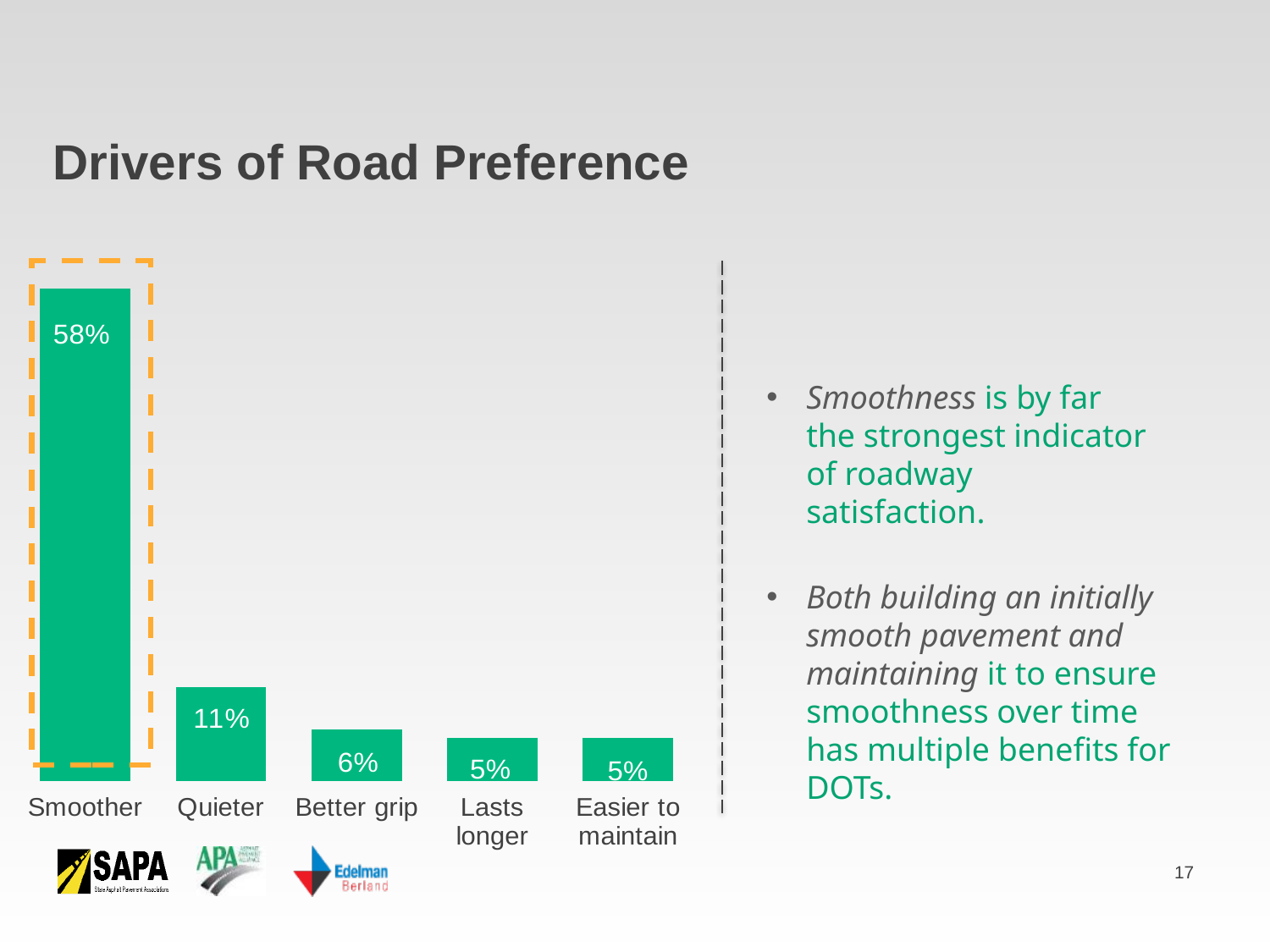
What percentage is shown for Lasts longer? 5% What is the difference between the values for Quieter and Better grip? 5% Which category has the highest value? Smoother Which is larger, the value for Quieter or the value for Better grip? Quieter What percentage is shown for Smoother? 58% What is the difference between the values for Smoother and Quieter? 47% Do the values rise or fall from left to right across the categories? Fall What kind of chart is shown on the slide? Bar chart What percentage is shown for Quieter? 11% What percentage is shown for Better grip? 6% Which bar is highlighted with a dashed orange outline? Smoother How many categories are shown in the chart? 5